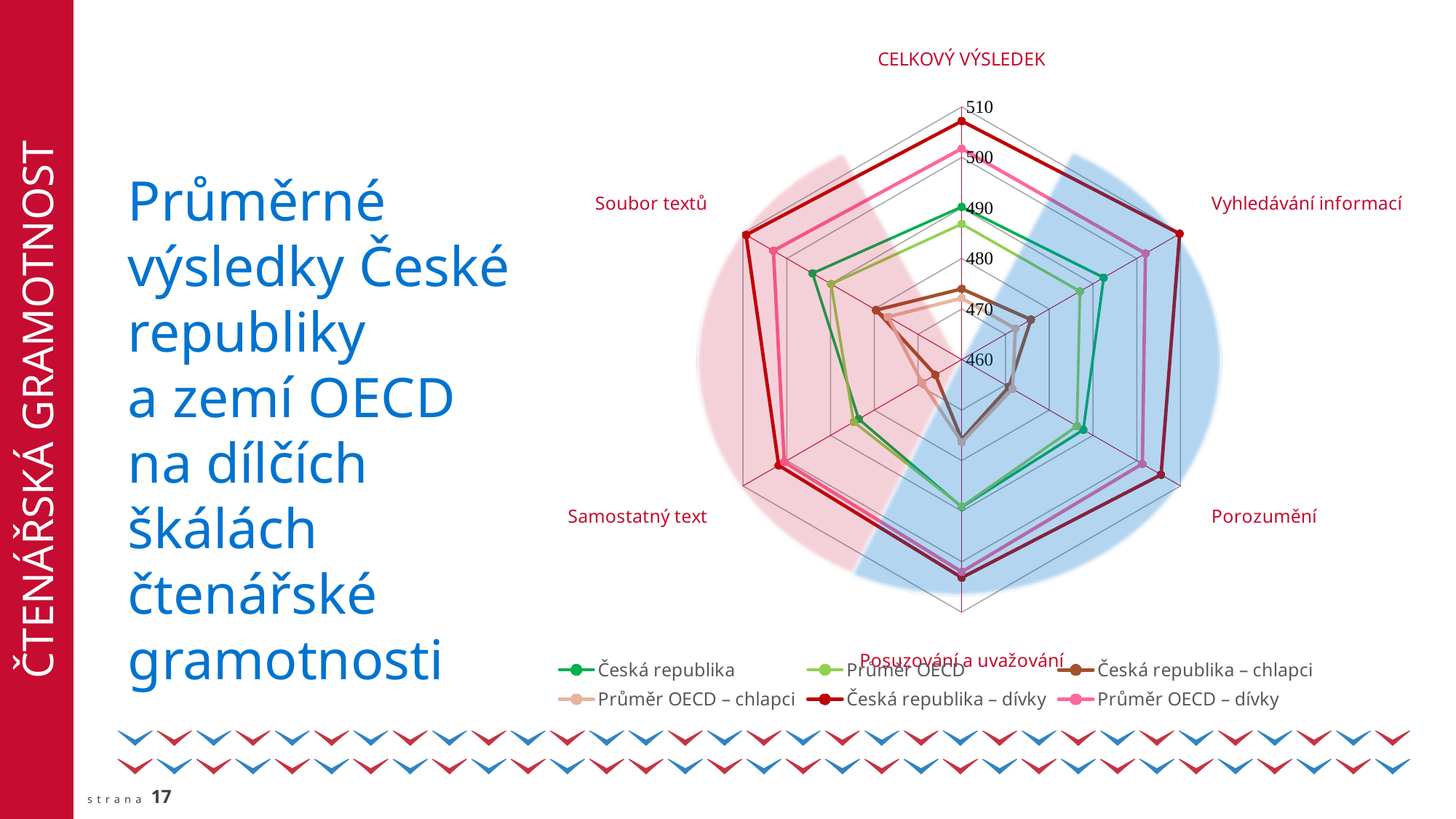
Is the value for Průměr OECD – chlapci on the Celkový výsledek axis greater or less than 480? less Which series has the lowest value on the Celkový výsledek axis? Průměr OECD – chlapci What colour is the line for Česká republika – dívky in the legend? dark red Is the value for Česká republika – dívky on the Celkový výsledek axis greater or less than 500? greater Which series has the highest value on the Celkový výsledek axis? Česká republika – dívky Is the value for Česká republika – chlapci on the Posuzování a uvažování axis greater or less than 480? less What kind of chart is shown on the slide? radar chart How many axes (categories) does the radar chart have? 6 On the Vyhledávání informací axis, which is higher: Česká republika – dívky or Průměr OECD – dívky? Česká republika – dívky On the Soubor textů axis, which is higher: Česká republika or Průměr OECD? Česká republika How many series does the legend list? 6